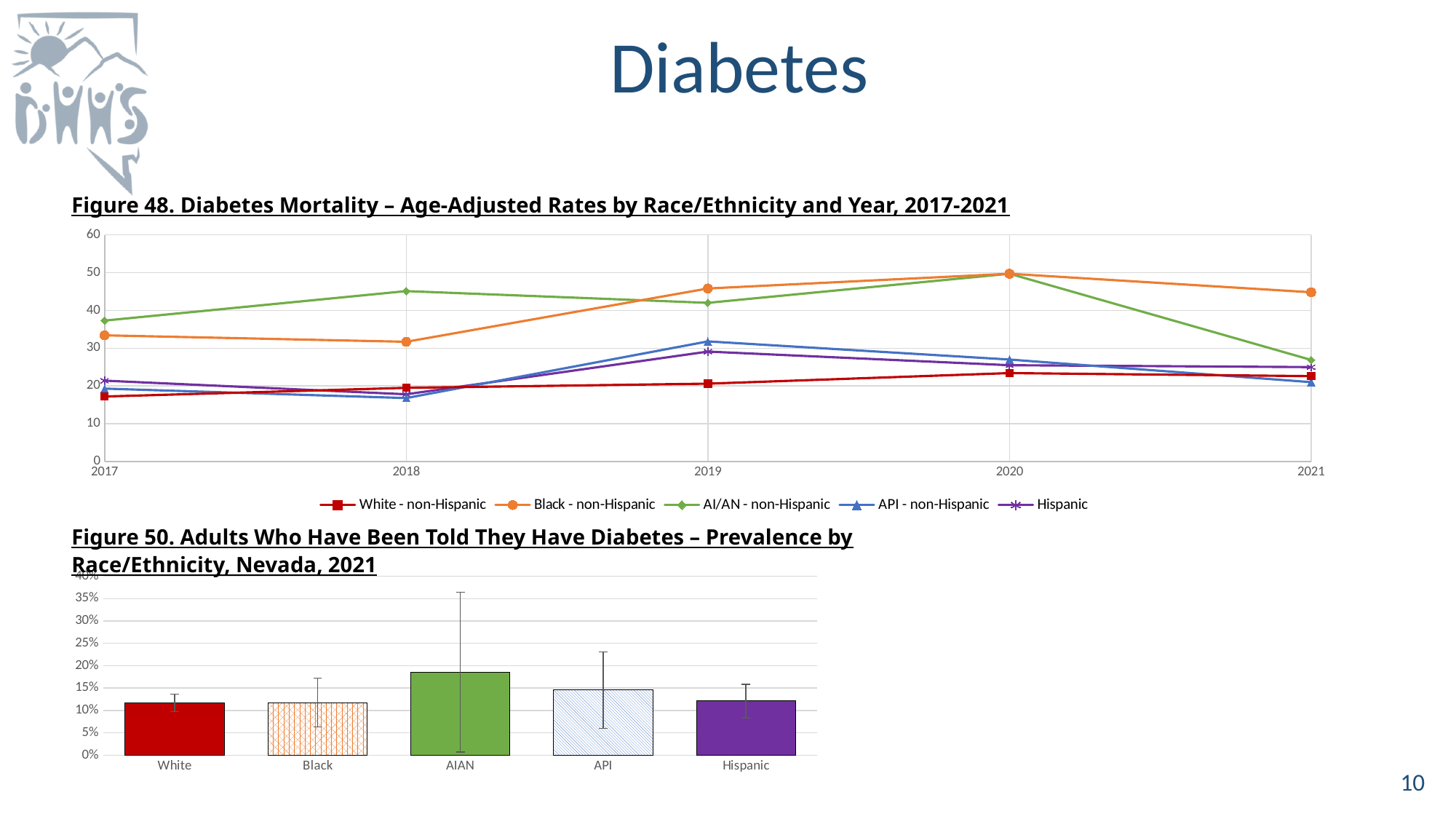
In Figure 48, is the 2021 value for AI/AN - non-Hispanic greater or less than 30? less In Figure 48, which race/ethnicity group had the highest diabetes mortality rate in 2018? AI/AN - non-Hispanic In Figure 48, is the 2018 value for AI/AN - non-Hispanic greater or less than 40? greater In Figure 50, which race/ethnicity group has the highest diabetes prevalence? AIAN What kind of chart is Figure 50? bar chart In Figure 48, does the Black - non-Hispanic rate rise or fall from 2018 to 2020? rise In Figure 50, is the value for AIAN greater or less than 15%? greater In Figure 48, which is larger in 2021: the value for Black - non-Hispanic or AI/AN - non-Hispanic? Black - non-Hispanic In Figure 48, which race/ethnicity group had the lowest diabetes mortality rate in 2017? White - non-Hispanic In Figure 48, how many years are plotted along the x axis? 5 In Figure 48, how many series does the legend list? 5